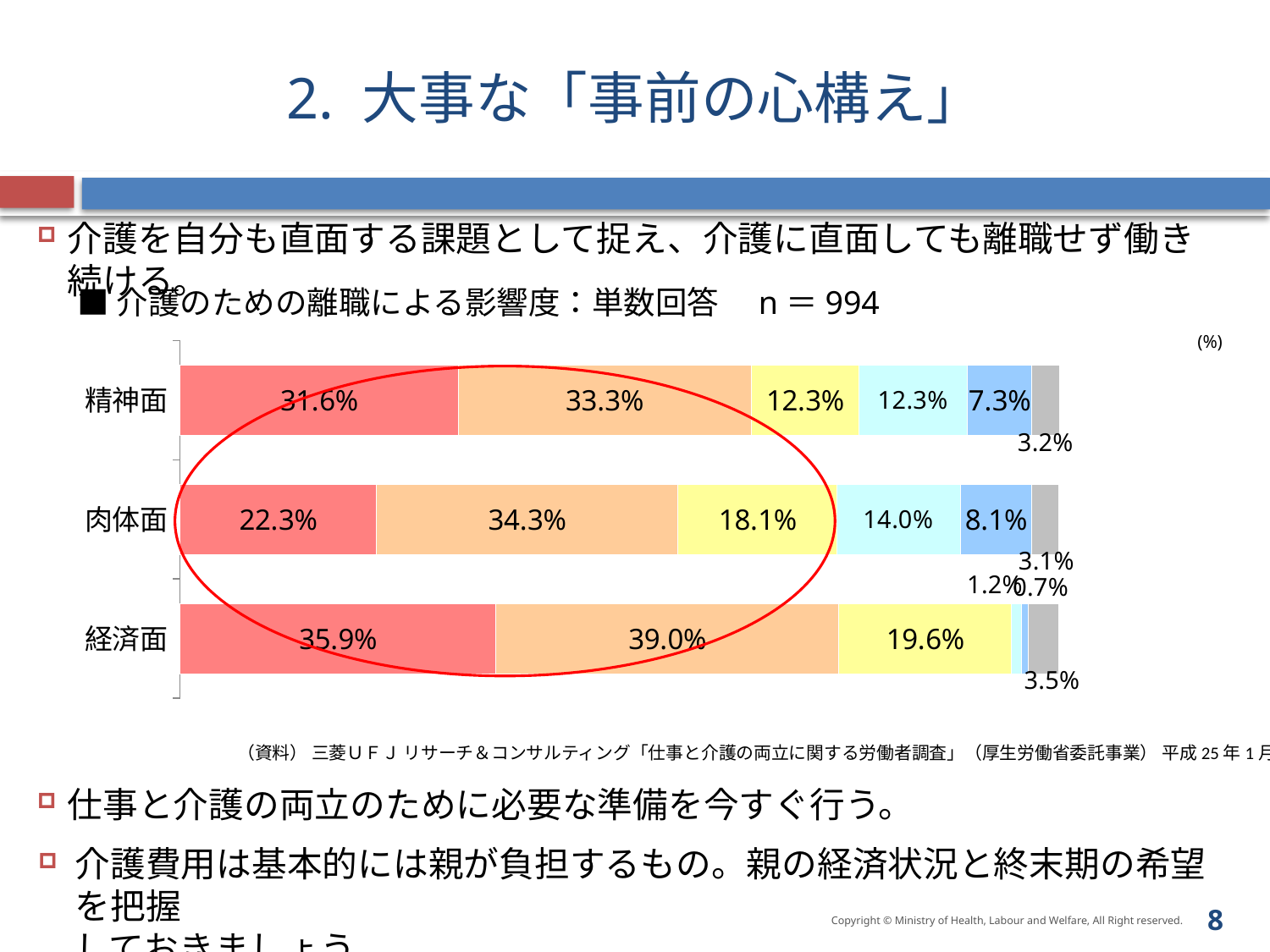
Which is larger: the second (orange) segment for 肉体面 or for 精神面? 肉体面 What kind of chart is shown on the slide? stacked bar chart What is the difference between the first (red) segment values of 経済面 and 肉体面? 13.6% What is the sample size (n) stated in the chart heading? 994 What is the value of the third (yellow) segment for 肉体面? 18.1% How many categories are plotted on the chart? 3 What is the value of the light blue segment for 経済面? 1.2% What is the value of the last (gray) segment for 経済面? 3.5% Which category has the lowest value in the third (yellow) segment? 精神面 What is the value of the second (orange) segment for 経済面? 39.0% What is the value of the first (red) segment for 精神面? 31.6% Which category has the highest value in the first (red) segment? 経済面